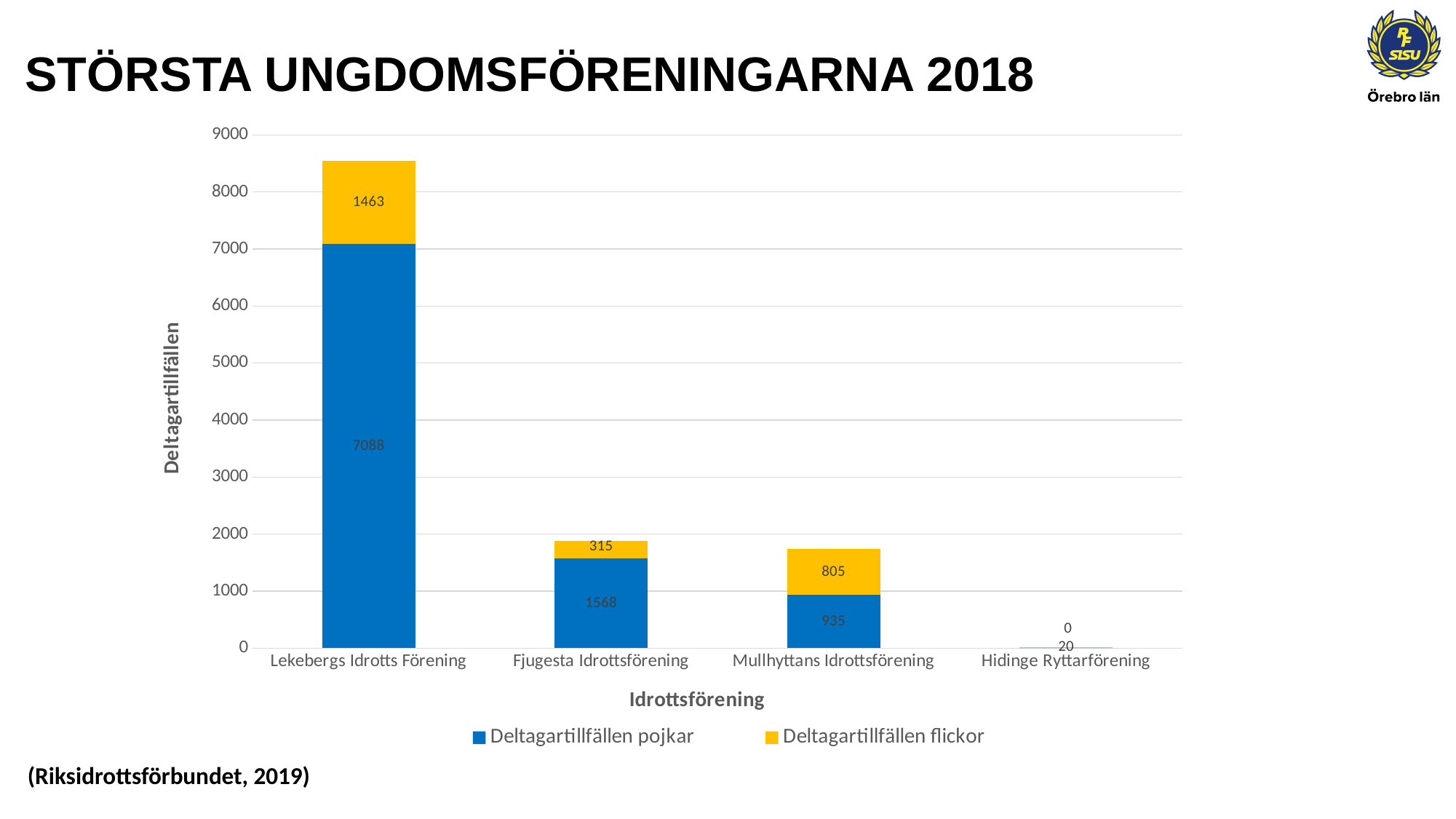
What kind of chart is shown on the slide? Stacked bar chart What is the value of Deltagartillfällen flickor for Mullhyttans Idrottsförening? 805 How many Idrottsföreningar are shown on the x axis? 4 How many series does the legend list? 2 What is the difference between Deltagartillfällen pojkar and Deltagartillfällen flickor for Lekebergs Idrotts Förening? 5625 Which has more Deltagartillfällen flickor, Fjugesta Idrottsförening or Mullhyttans Idrottsförening? Mullhyttans Idrottsförening What is the total of the stacked bar for Fjugesta Idrottsförening? 1883 Which Idrottsförening has the lowest total Deltagartillfällen? Hidinge Ryttarförening Which Idrottsförening has the highest total Deltagartillfällen? Lekebergs Idrotts Förening What is the total height of the stacked bar for Lekebergs Idrotts Förening? 8551 How many Deltagartillfällen pojkar are shown for Lekebergs Idrotts Förening? 7088 What is the value of Deltagartillfällen flickor for Fjugesta Idrottsförening? 315